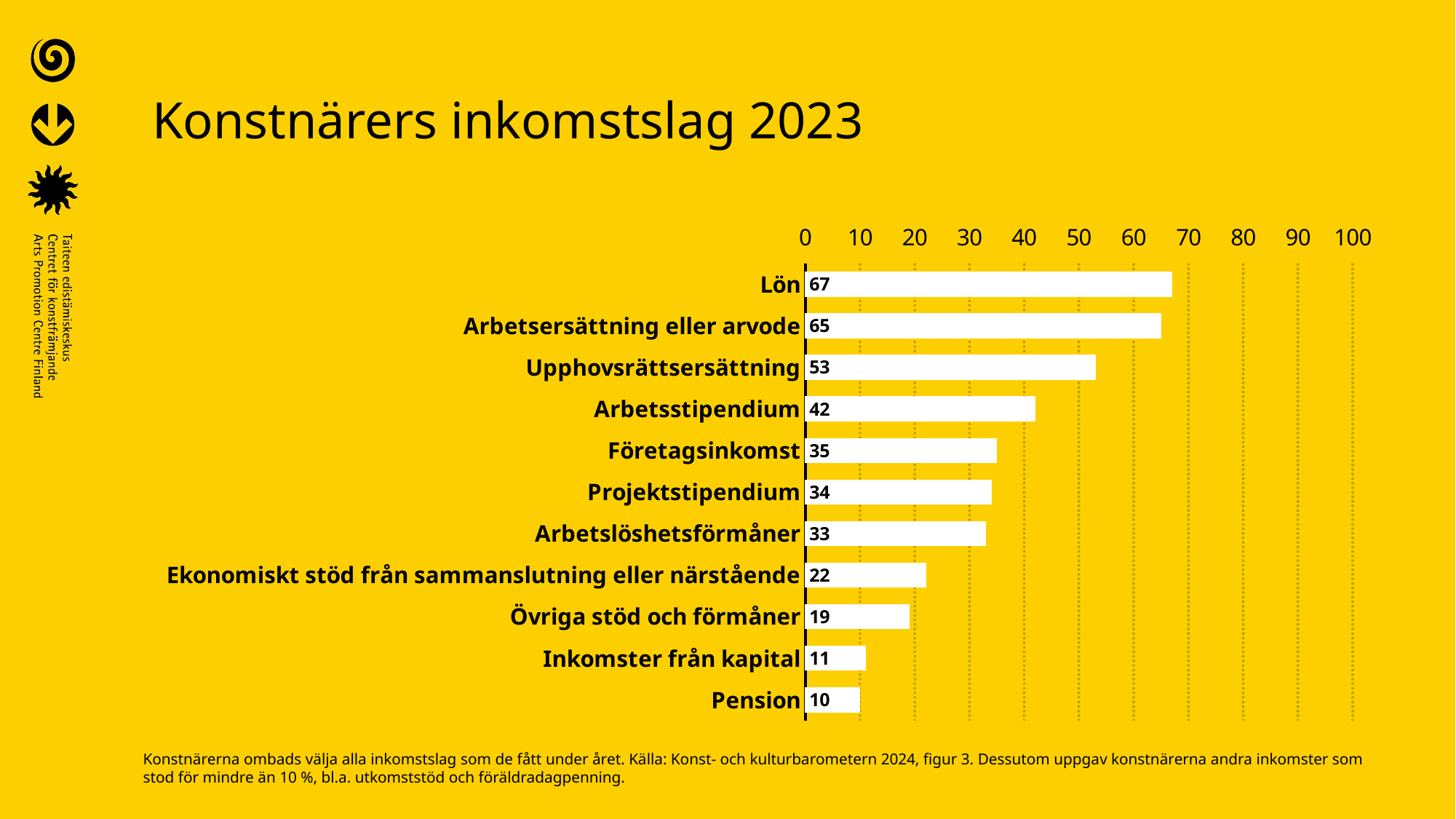
What is the difference between the values for Lön and Arbetsstipendium? 25 What is the value for Lön? 67 Which category has the highest value? Lön What kind of chart is shown on the slide? bar chart What is the title of the slide? Konstnärers inkomstslag 2023 Is the value for Arbetsersättning eller arvode greater or less than 60? greater What is the highest value shown on the axis? 100 Which is larger, the value for Företagsinkomst or the value for Övriga stöd och förmåner? Företagsinkomst What is the value for Ekonomiskt stöd från sammanslutning eller närstående? 22 What is the value for Upphovsrättsersättning? 53 Which category has the lowest value? Pension How many categories are shown in the chart? 11